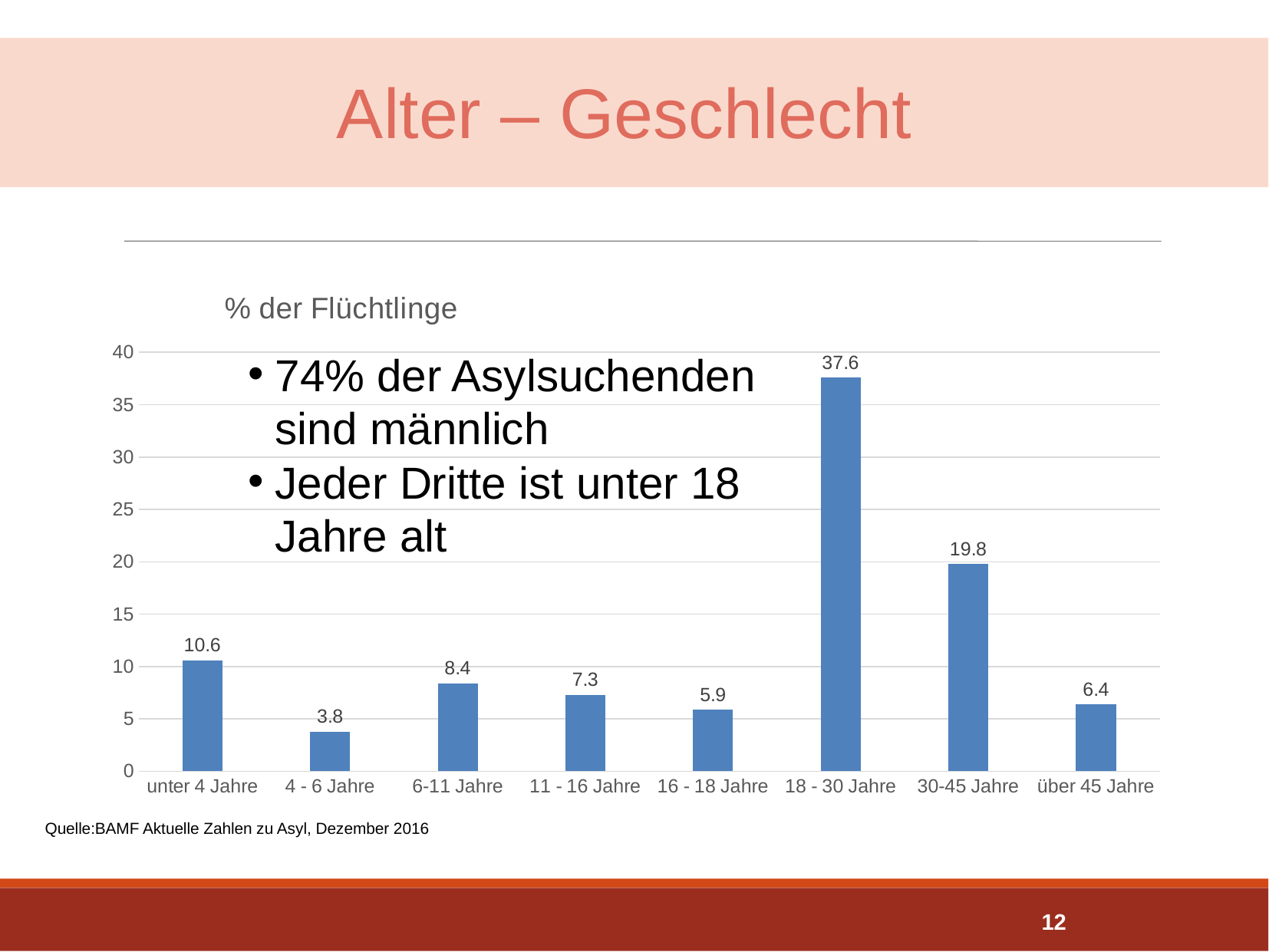
What is the value for the '18 - 30 Jahre' category? 37.6 What is the title of the chart? % der Flüchtlinge What is the difference between the values for 'unter 4 Jahre' and '4 - 6 Jahre'? 6.8 What is the difference between the values for '18 - 30 Jahre' and '30-45 Jahre'? 17.8 Is the value for '30-45 Jahre' greater or less than 15? greater How many age categories are shown on the x axis? 8 What is the value for the 'unter 4 Jahre' category? 10.6 What is the value for the 'über 45 Jahre' category? 6.4 Which age category has the highest value? 18 - 30 Jahre Which is larger, the value for '6-11 Jahre' or the value for '11 - 16 Jahre'? 6-11 Jahre Which age category has the lowest value? 4 - 6 Jahre What kind of chart is shown on the slide? bar chart